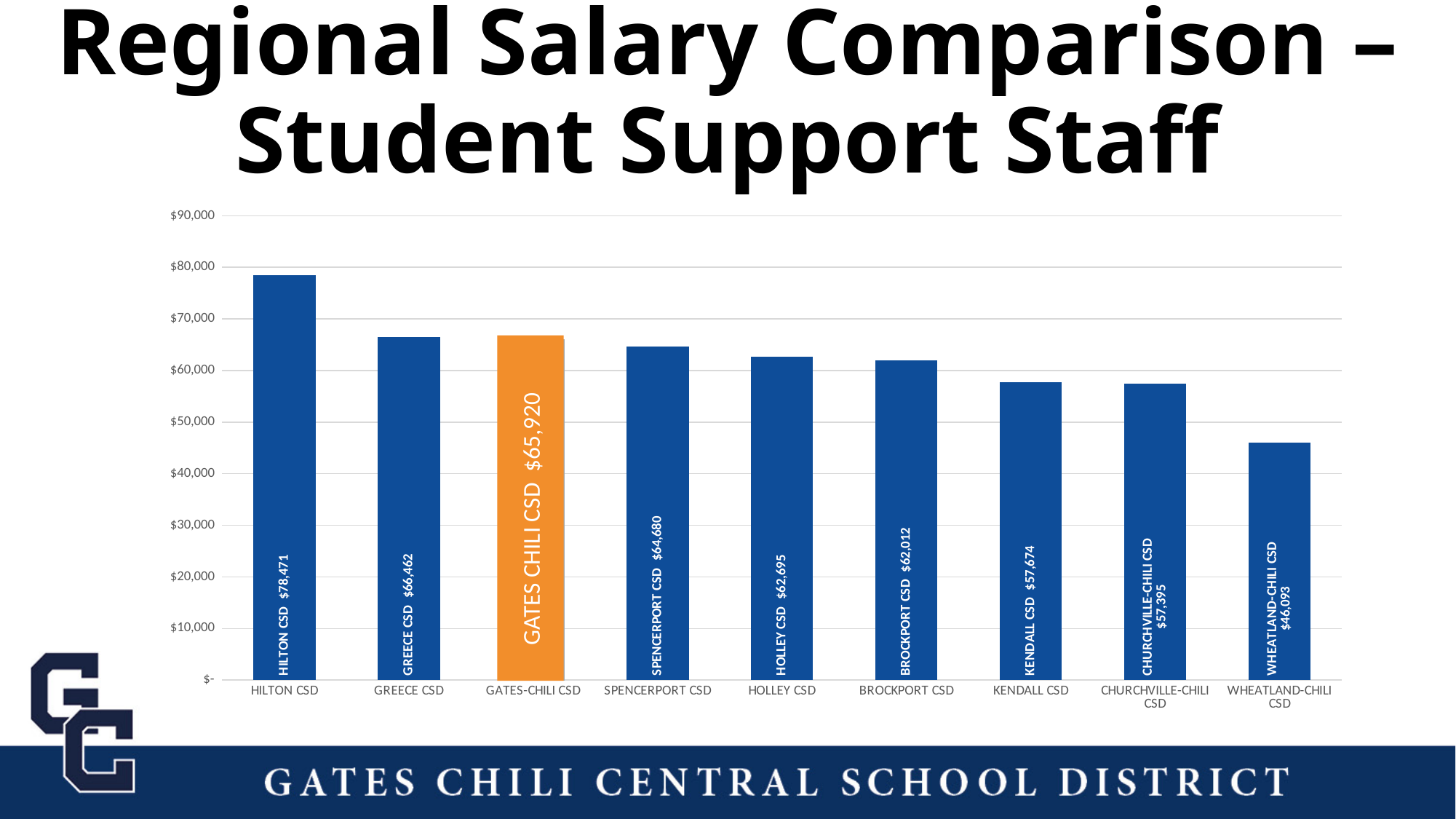
Is the value for Kendall CSD greater or less than $60,000? less What kind of chart is shown on the slide? Bar chart How many districts are shown on the chart? 9 What is the salary shown for Hilton CSD? $78,471 What is the difference between the Hilton CSD salary and the Wheatland-Chili CSD salary? $32,378 What is the salary shown for Brockport CSD? $62,012 Which is larger, the salary for Spencerport CSD or the salary for Holley CSD? Spencerport CSD Which district has the highest salary on the chart? Hilton CSD What is the salary shown for Gates-Chili CSD? $65,920 What is the difference between the Hilton CSD salary and the Gates-Chili CSD salary? $12,551 What is the salary shown for Wheatland-Chili CSD? $46,093 Which district has the lowest salary on the chart? Wheatland-Chili CSD